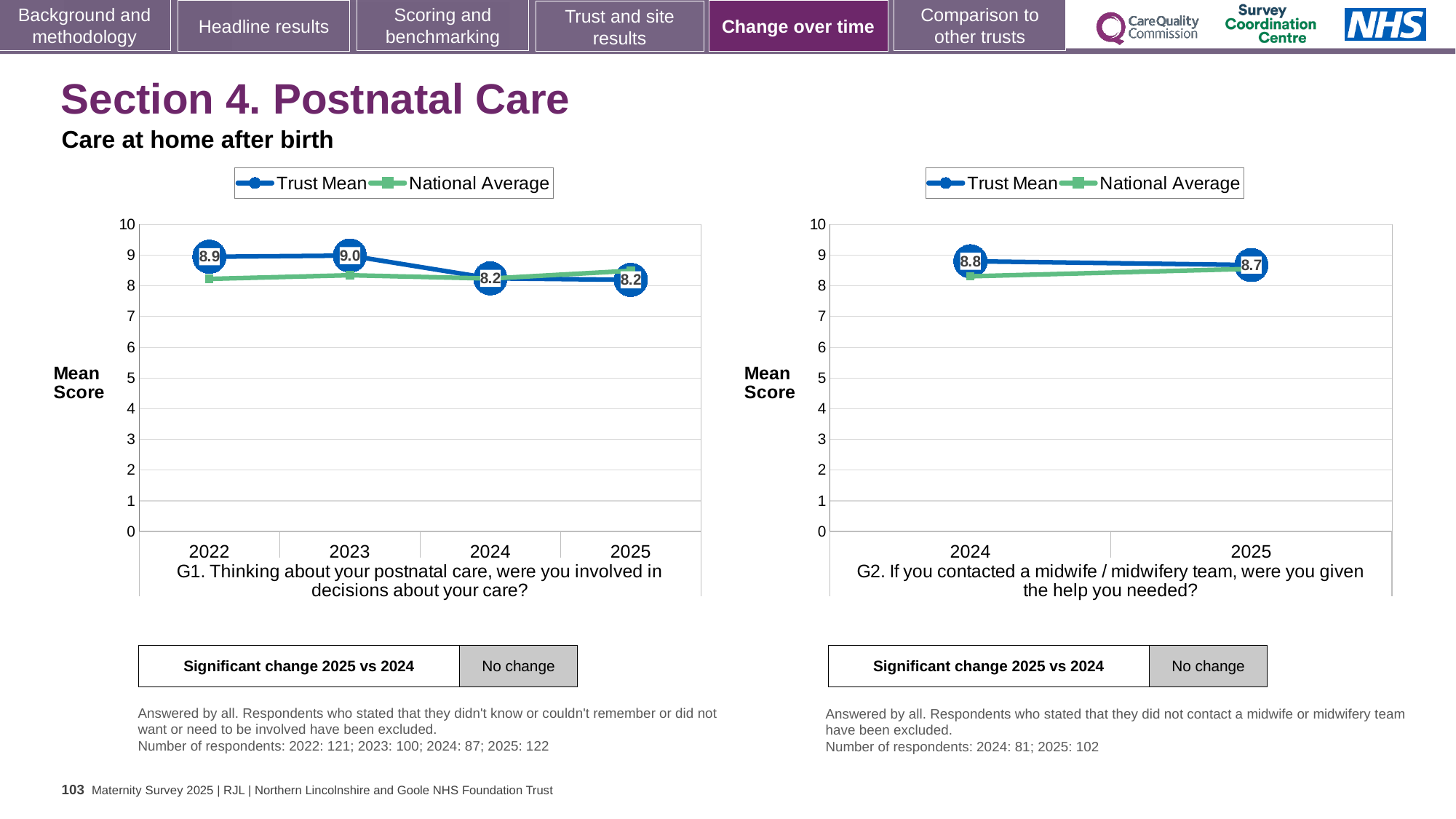
In the G1 chart (left), what is the difference between the Trust Mean scores for 2023 and 2025? 0.8 What kind of chart is the G2 chart (right)? line chart How many series does the legend of the G2 chart (right) list? 2 In the G1 chart (left), which year has the highest Trust Mean score? 2023 In the G1 chart (left), is the National Average for 2022 greater or less than 7? greater In the G1 chart (left), is the Trust Mean score higher in 2022 or in 2024? 2022 In the G1 chart (left), what is the Trust Mean score for 2023? 9.0 In the G2 chart (right), what is the Trust Mean score for 2024? 8.8 In the G1 chart (left), does the Trust Mean rise or fall from 2022 to 2025? fall In the G2 chart (right), what is the difference between the Trust Mean scores for 2024 and 2025? 0.1 In the G1 chart (left), how many years are shown on the x axis? 4 In the G1 chart (left), what is the Trust Mean score for 2025? 8.2